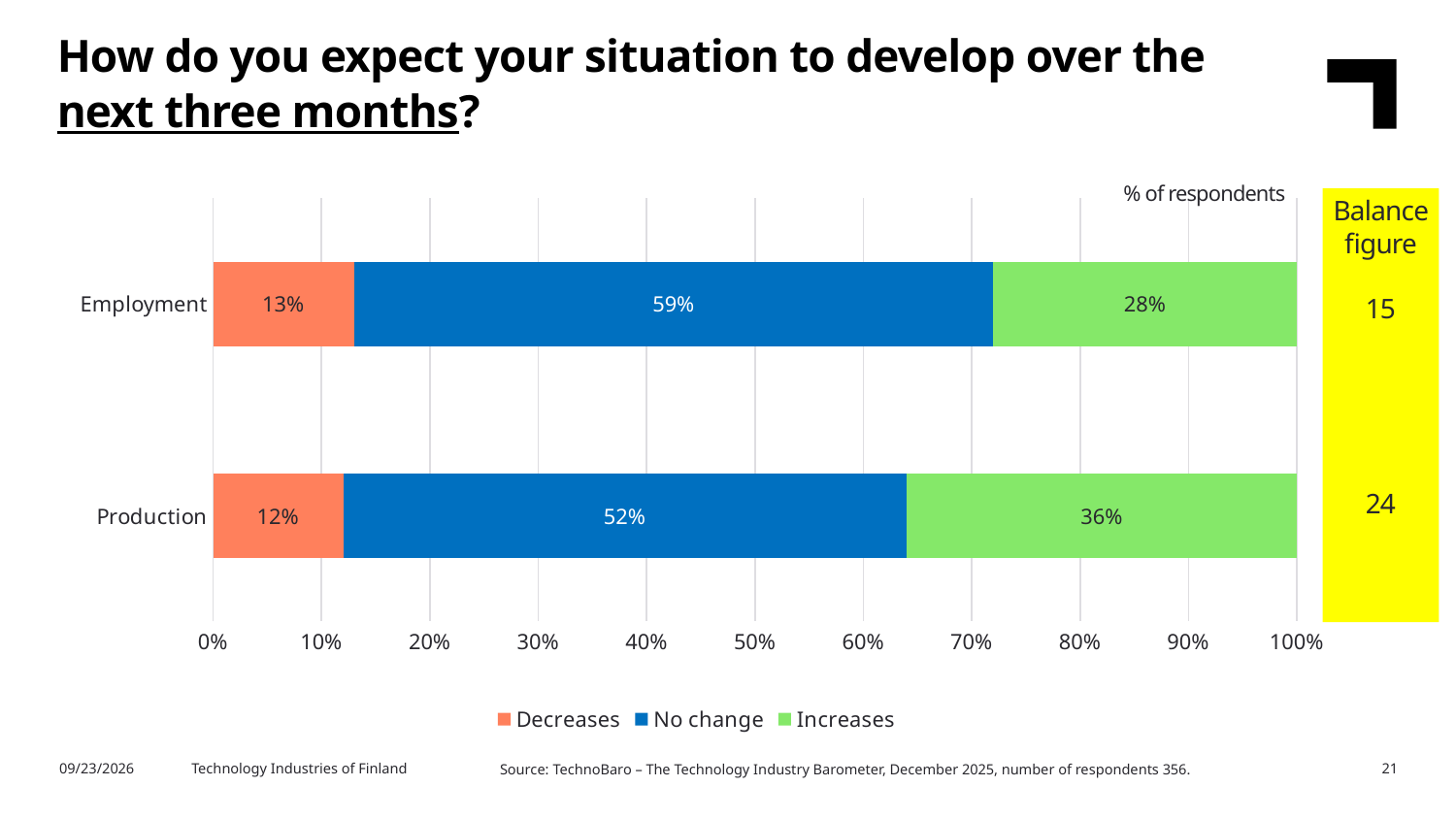
What kind of chart is shown on the slide? Stacked bar chart What is the total of the three segments in the Production bar? 100% What is the balance figure shown for Production? 24 What is the difference between the 'No change' share for Employment and for Production? 7 percentage points Which category has the larger share of respondents expecting increases, Employment or Production? Production What is the difference between the 'Increases' share for Production and for Employment? 8 percentage points What percentage of respondents expect employment to show no change over the next three months? 59% Which colour represents the 'Increases' series in the legend? Green What percentage of respondents expect production to increase? 36% What percentage of respondents expect employment to decrease? 13% How many categories are shown on the chart? 2 How many series does the legend list? 3